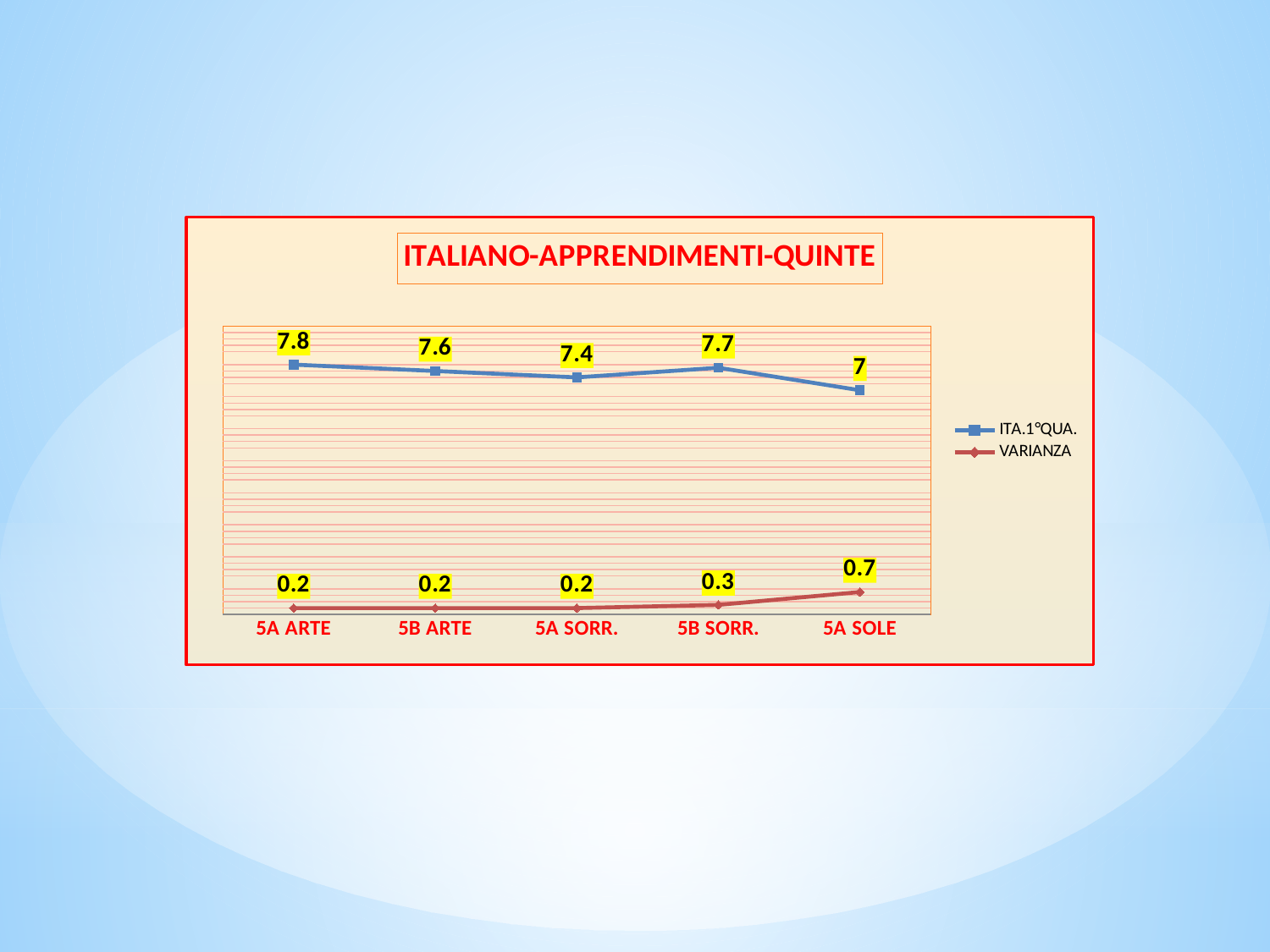
What is the title of the chart? ITALIANO-APPRENDIMENTI-QUINTE How many categories are shown on the x axis? 5 What kind of chart is this? Line chart What is the difference between the ITA.1°QUA. values for 5A ARTE and 5A SOLE? 0.8 Which category has the highest ITA.1°QUA. value? 5A ARTE How many series does the legend list? 2 Which is larger, the ITA.1°QUA. value for 5B ARTE or for 5A SORR.? 5B ARTE What is the ITA.1°QUA. value for 5B SORR.? 7.7 What is the ITA.1°QUA. value for 5A ARTE? 7.8 What is the VARIANZA value for 5A SOLE? 0.7 Which category has the lowest ITA.1°QUA. value? 5A SOLE Which category has the highest VARIANZA value? 5A SOLE